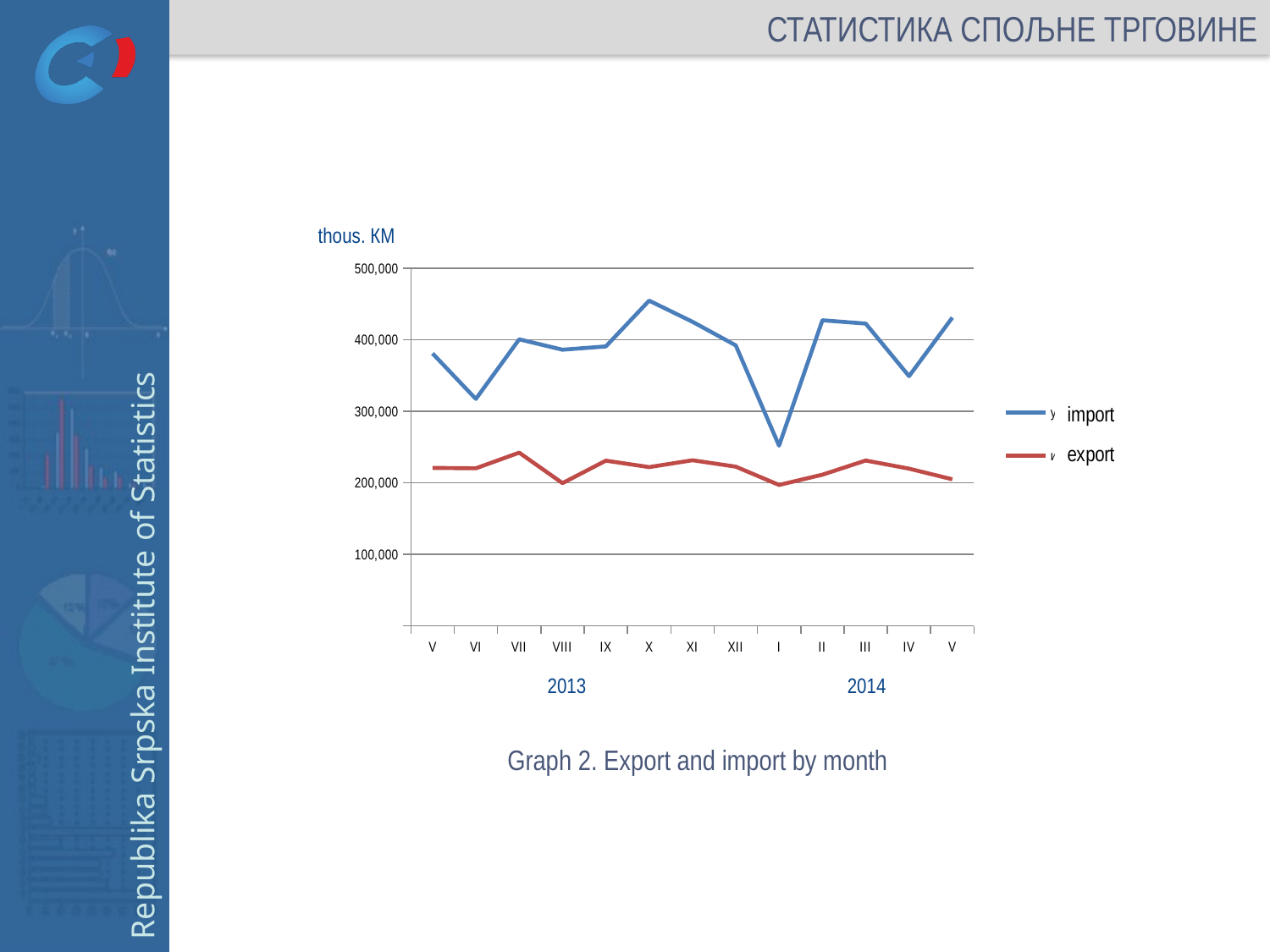
In which month is the import value lowest? I 2014 How many series does the legend list? 2 In which month is the import value highest? X 2013 Is the import value for X 2013 greater or less than 400,000? greater What unit is shown above the chart? thous. KM Which is larger in X 2013, import or export? import Is the export value for VII 2013 greater or less than 200,000? greater Is the import value for IV 2014 greater or less than 400,000? less How many months are plotted along the x axis? 13 Does the import value rise or fall from XII 2013 to I 2014? fall What kind of chart is shown on the slide? line chart